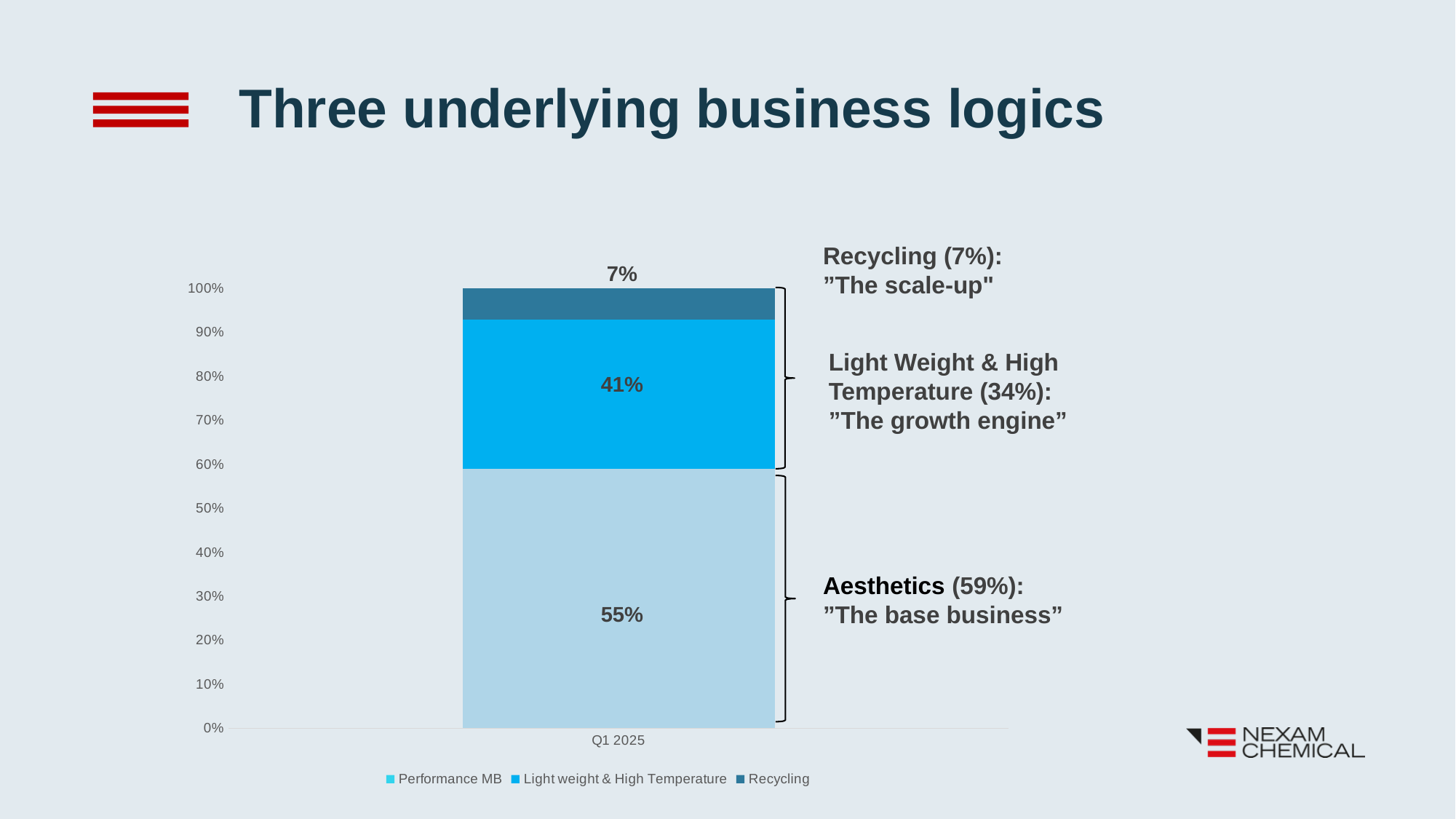
Which segment is larger in the Q1 2025 bar: Performance MB or Light weight & High Temperature? Performance MB What kind of chart is shown on the slide? Stacked bar chart How many series does the legend list? 3 What is the category label on the x axis? Q1 2025 By how many percentage points does the Performance MB label exceed the Light weight & High Temperature label? 14 percentage points What is the data label for the Recycling segment in the Q1 2025 bar? 7% How many categories are shown on the x axis? 1 Which series is shown in the darkest blue at the top of the bar? Recycling What is the data label for the Light weight & High Temperature segment in the Q1 2025 bar? 41% Which series has the smallest segment in the Q1 2025 bar? Recycling What is the data label for the Performance MB segment in the Q1 2025 bar? 55% Which series has the largest segment in the Q1 2025 bar? Performance MB